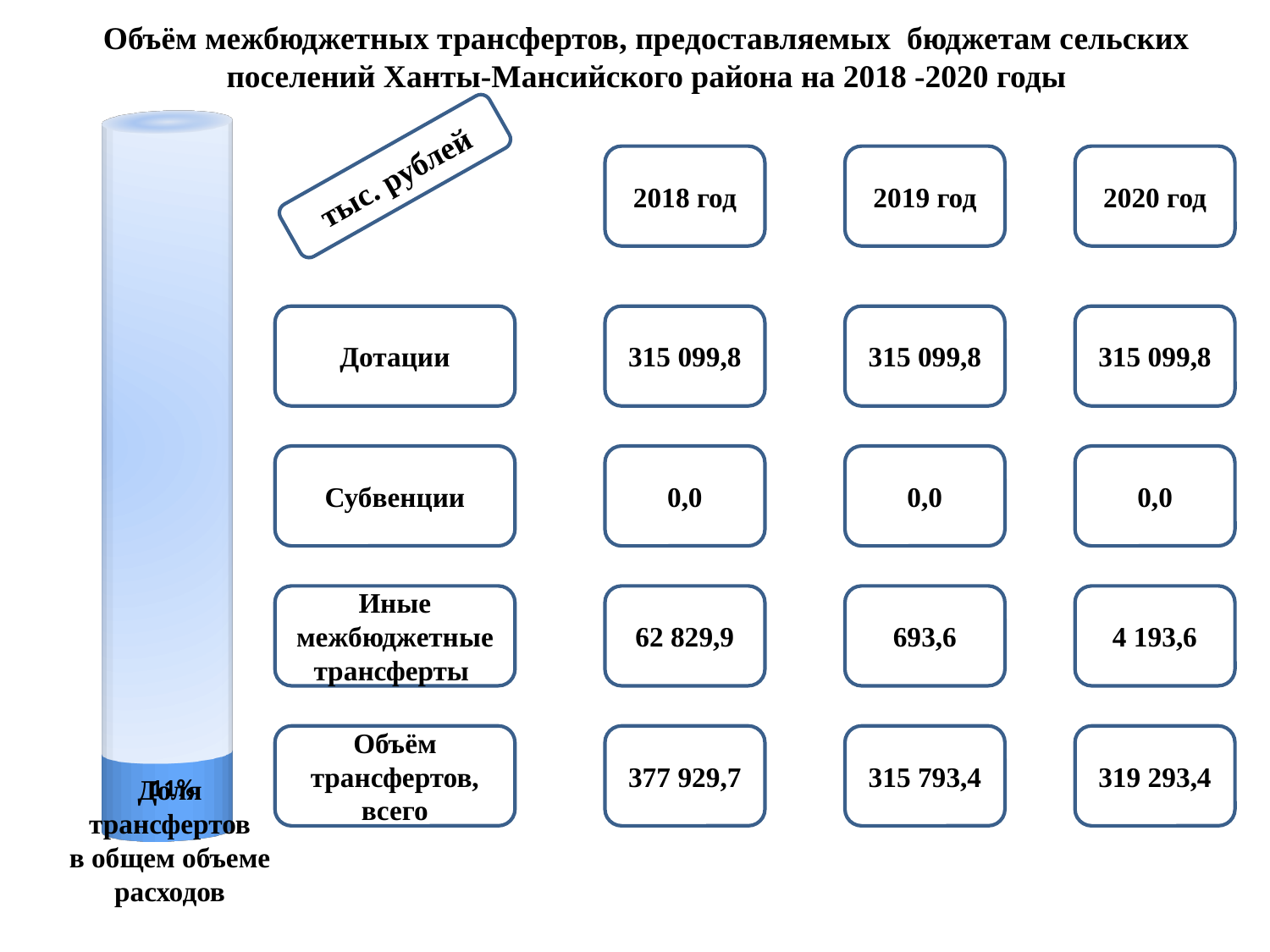
What unit of measurement is indicated for the values in the table? тыс. рублей In which year is Иные межбюджетные трансферты the lowest? 2019 год In which year is Объём трансфертов, всего the highest? 2018 год On the cylinder chart at the left, what share of total expenditures do transfers make up? 11% Which year has the larger Объём трансфертов, всего: 2019 год or 2020 год? 2020 год What is the value of Субвенции for 2019 год? 0,0 What is the value of Дотации for 2018 год? 315 099,8 What is the value of Объём трансфертов, всего for 2020 год? 319 293,4 What does the cylinder chart at the left of the slide represent, according to its caption? Доля трансфертов в общем объеме расходов How many years are shown as columns in the table? 3 What is the value of Иные межбюджетные трансферты for 2019 год? 693,6 By how much does Объём трансфертов, всего in 2018 год exceed that in 2019 год? 62 136,3